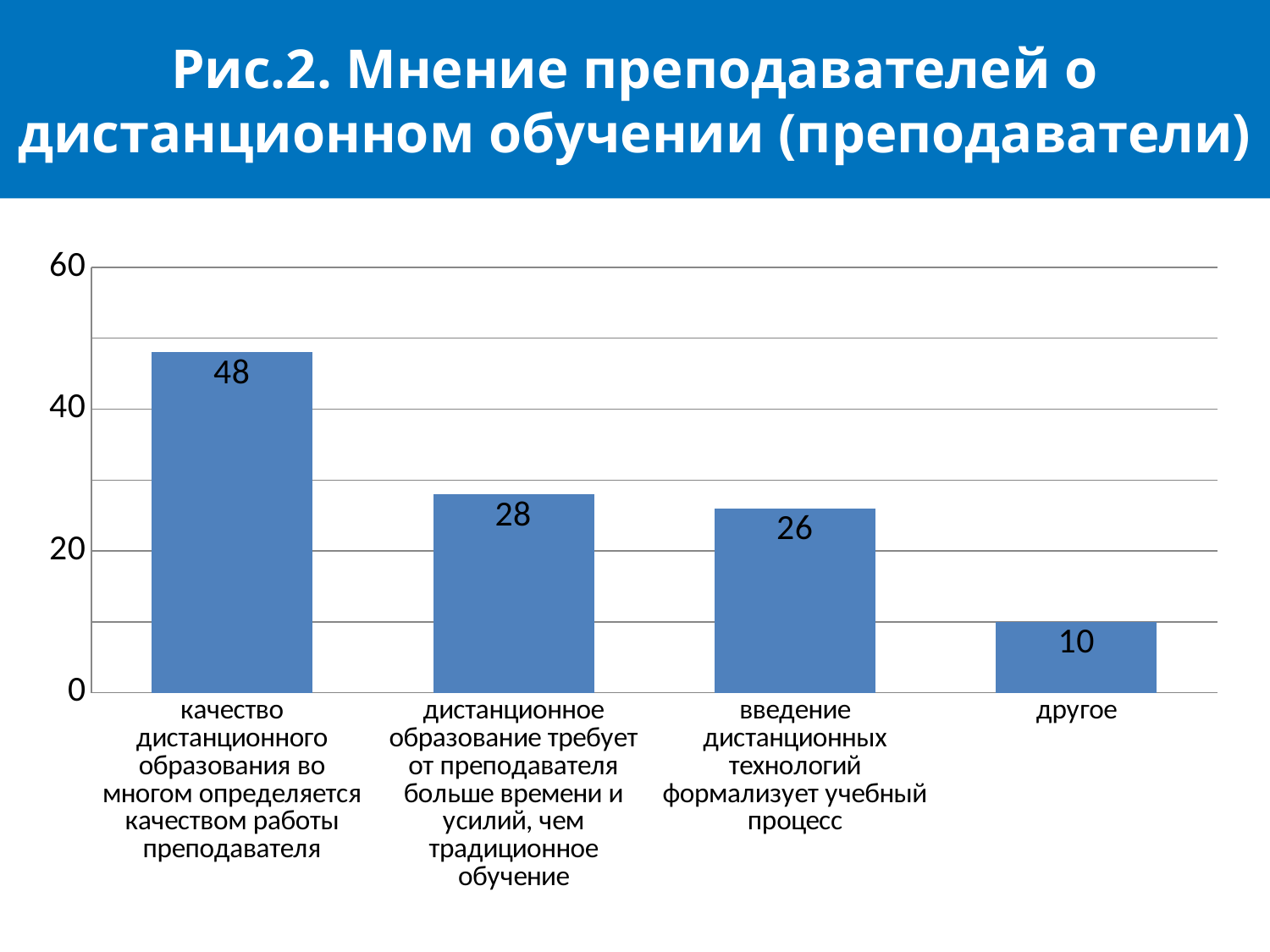
What kind of chart is shown on the slide? bar chart What is the value for the category "введение дистанционных технологий формализует учебный процесс"? 26 What is the value for the category "дистанционное образование требует от преподавателя больше времени и усилий, чем традиционное обучение"? 28 How many categories are shown on the chart? 4 Is the value for "введение дистанционных технологий формализует учебный процесс" greater or less than 40? less What is the title of the slide? Рис.2. Мнение преподавателей о дистанционном обучении (преподаватели) What is the difference between the value for "качество дистанционного образования во многом определяется качеством работы преподавателя" and the value for "другое"? 38 What is the difference between the values for "дистанционное образование требует от преподавателя больше времени и усилий, чем традиционное обучение" and "введение дистанционных технологий формализует учебный процесс"? 2 Which category has the lowest value? другое What is the value for the category "другое"? 10 Which category has the highest value? качество дистанционного образования во многом определяется качеством работы преподавателя Which is larger: the value for "качество дистанционного образования во многом определяется качеством работы преподавателя" or the value for "дистанционное образование требует от преподавателя больше времени и усилий, чем традиционное обучение"? качество дистанционного образования во многом определяется качеством работы преподавателя